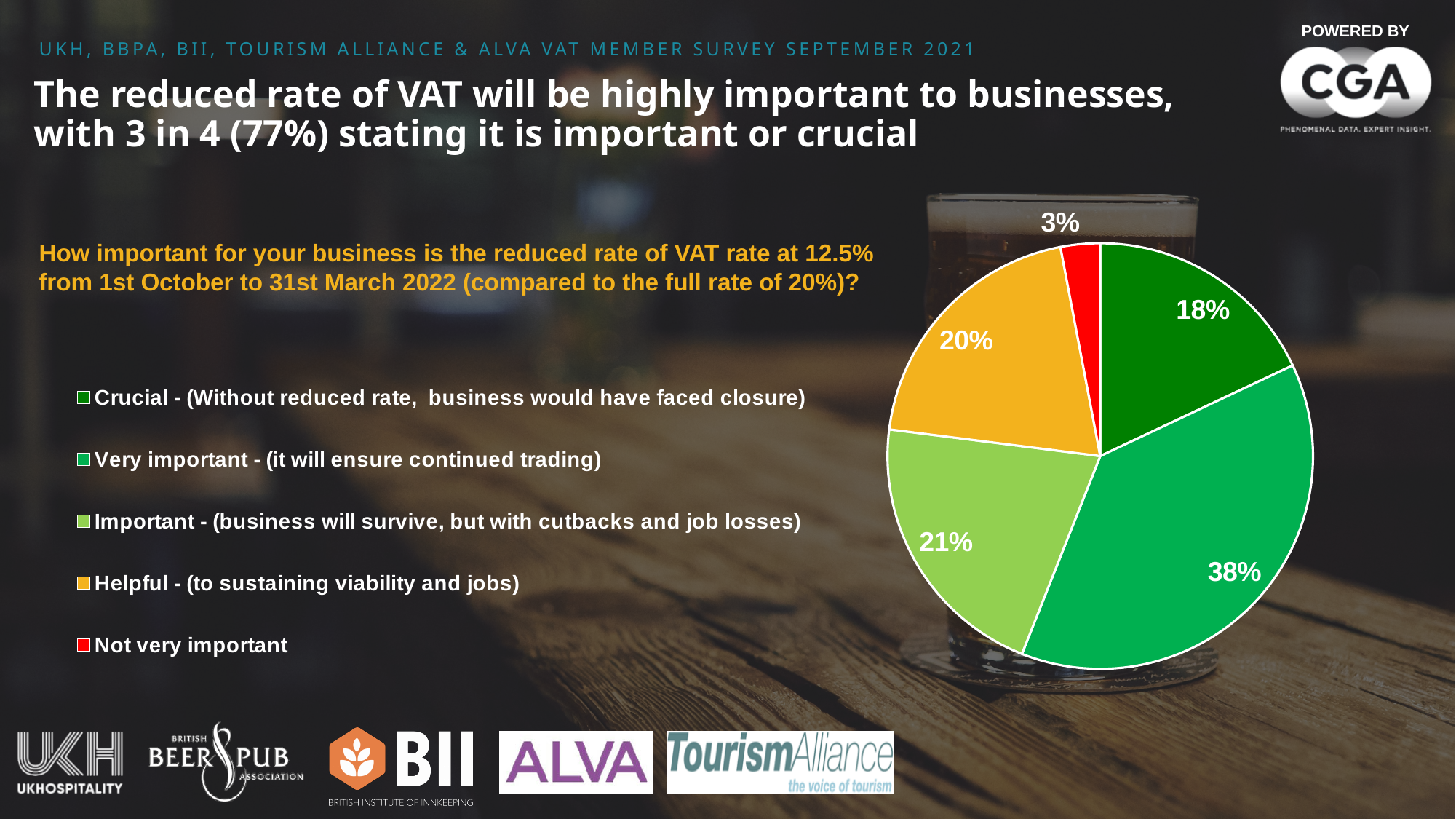
What colour is the slice for 'Not very important'? red Which response category has the largest slice of the pie? Very important What share of respondents said the reduced rate of VAT is 'Crucial'? 18% Which is larger: the share for 'Important' or the share for 'Crucial'? Important What is the combined share of 'Crucial' and 'Very important'? 56% Which response category has the smallest slice of the pie? Not very important What is the difference in percentage points between 'Very important' and 'Crucial'? 20 How many categories does the pie chart show? 5 What share of respondents said the reduced rate of VAT is 'Very important'? 38% What share of respondents said the reduced rate of VAT is 'Helpful'? 20% What share of respondents said the reduced rate of VAT is 'Not very important'? 3% What kind of chart is shown on the slide? pie chart